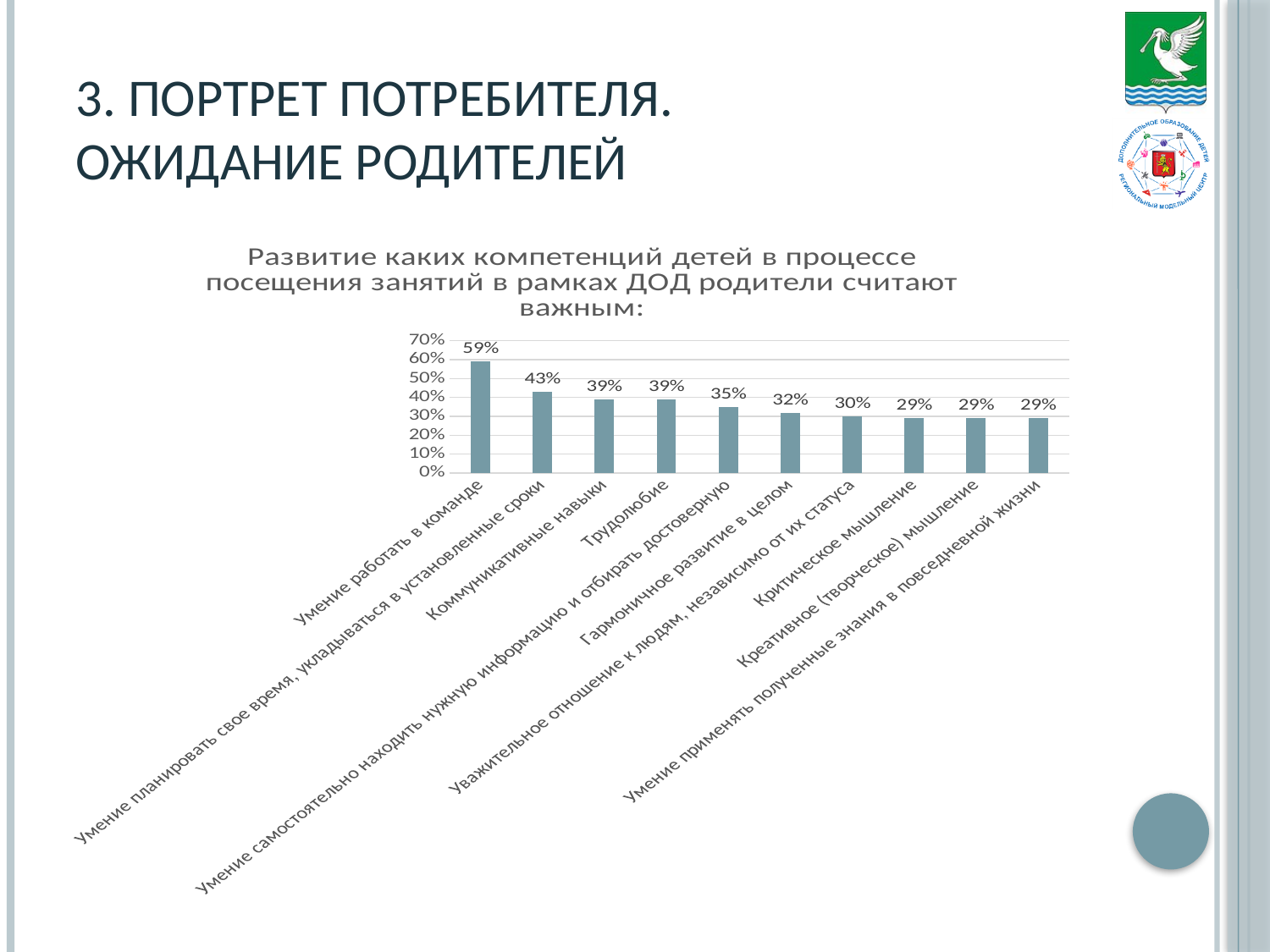
What is the difference between the values for "Умение работать в команде" and "Умение планировать свое время, укладываться в установленные сроки"? 16% Do the values rise or fall from left to right along the x axis? Fall What is the value for "Умение работать в команде"? 59% What is the lowest value shown in the chart? 29% What is the value for "Уважительное отношение к людям, независимо от их статуса"? 30% What is the value for "Гармоничное развитие в целом"? 32% Which category has the highest value? Умение работать в команде How many categories are shown in the chart? 10 What type of chart is shown on the slide? Bar chart What is the value for "Критическое мышление"? 29% Which is larger: the value for "Трудолюбие" or the value for "Гармоничное развитие в целом"? Трудолюбие What is the value for "Умение планировать свое время, укладываться в установленные сроки"? 43%